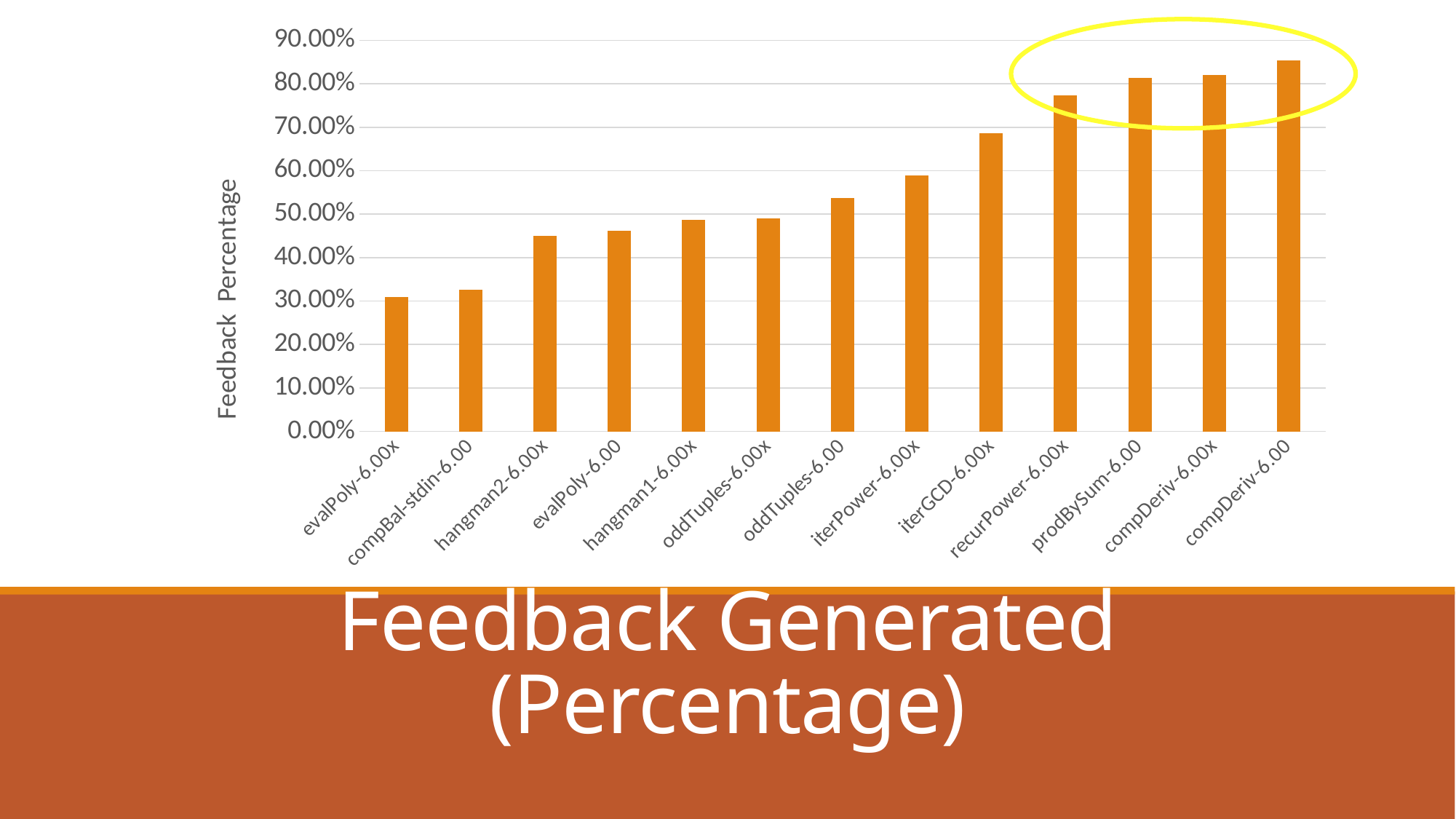
Is the value for evalPoly-6.00x greater or less than 40.00%? less What is the label on the vertical axis? Feedback Percentage What kind of chart is shown on the slide? bar chart Is the value for hangman2-6.00x greater or less than 50.00%? less Which has the larger value, iterGCD-6.00x or oddTuples-6.00? iterGCD-6.00x Is the value for recurPower-6.00x greater or less than 70.00%? greater Do the values generally rise or fall moving left to right along the x axis? rise Which category has the highest feedback percentage? compDeriv-6.00 Which category has the lowest feedback percentage? evalPoly-6.00x How many categories are plotted along the x axis? 13